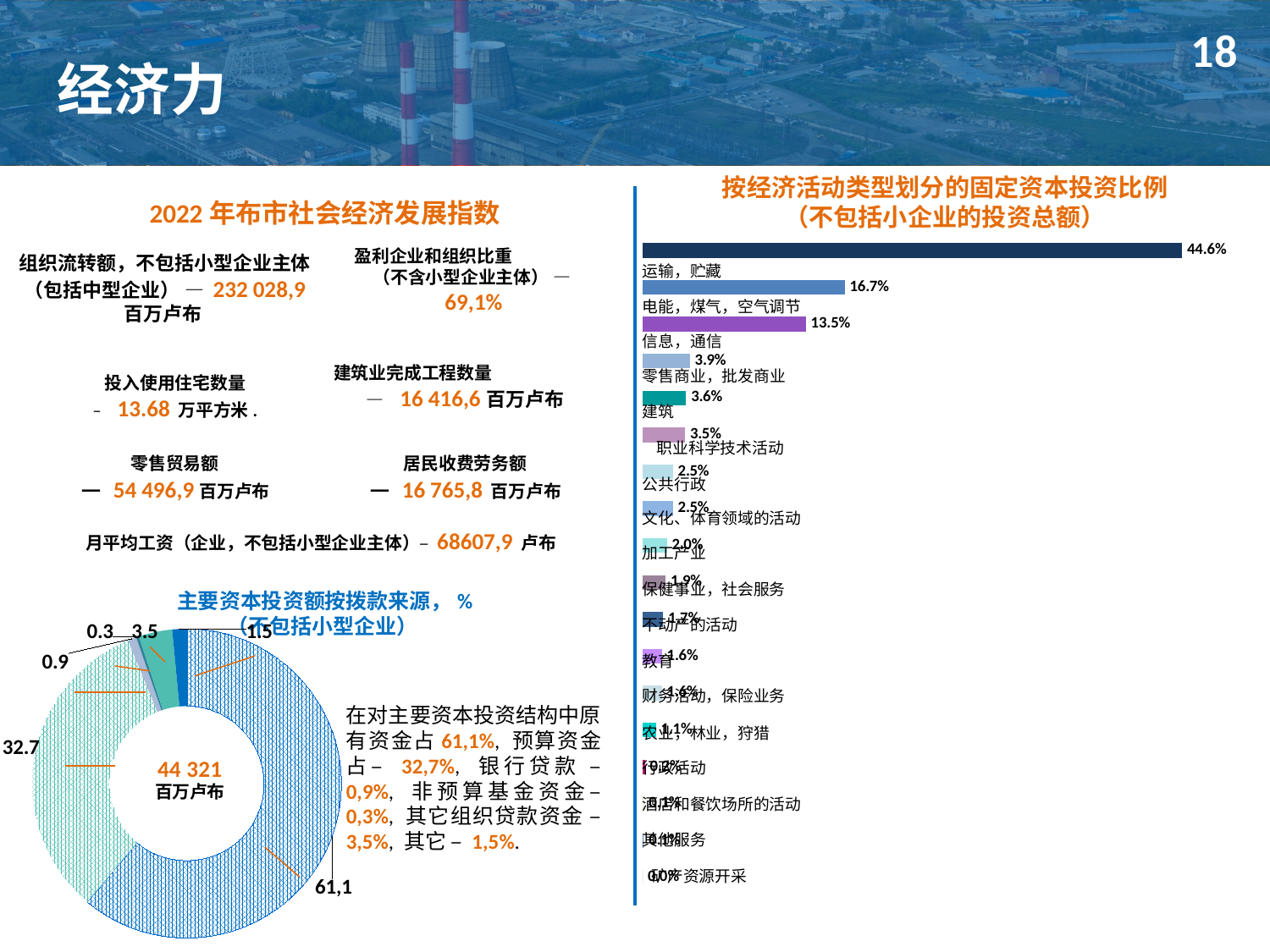
In the bar chart 按经济活动类型划分的固定资本投资比例, what is the value for 职业科学技术活动? 3.5% How many slices does the doughnut chart 主要资本投资额按拨款来源，% have? 6 What value is shown in the centre of the doughnut chart 主要资本投资额按拨款来源，%? 44 321 百万卢布 In the doughnut chart 主要资本投资额按拨款来源，%, what is the value of the largest slice? 61,1 In the bar chart 按经济活动类型划分的固定资本投资比例, which is larger: 零售商业，批发商业 or 建筑? 零售商业，批发商业 In the bar chart 按经济活动类型划分的固定资本投资比例, what is the value for 电能，煤气，空气调节? 16.7% In the bar chart 按经济活动类型划分的固定资本投资比例, what is the difference between 运输，贮藏 and 电能，煤气，空气调节? 27.9% What kind of chart is 按经济活动类型划分的固定资本投资比例 on the right of the slide? bar chart In the bar chart 按经济活动类型划分的固定资本投资比例, which category has the highest value? 运输，贮藏 In the bar chart 按经济活动类型划分的固定资本投资比例, what is the value for 信息，通信? 13.5% What kind of chart is 主要资本投资额按拨款来源，% at the bottom left of the slide? doughnut chart In the bar chart 按经济活动类型划分的固定资本投资比例, what is the value for 运输，贮藏? 44.6%